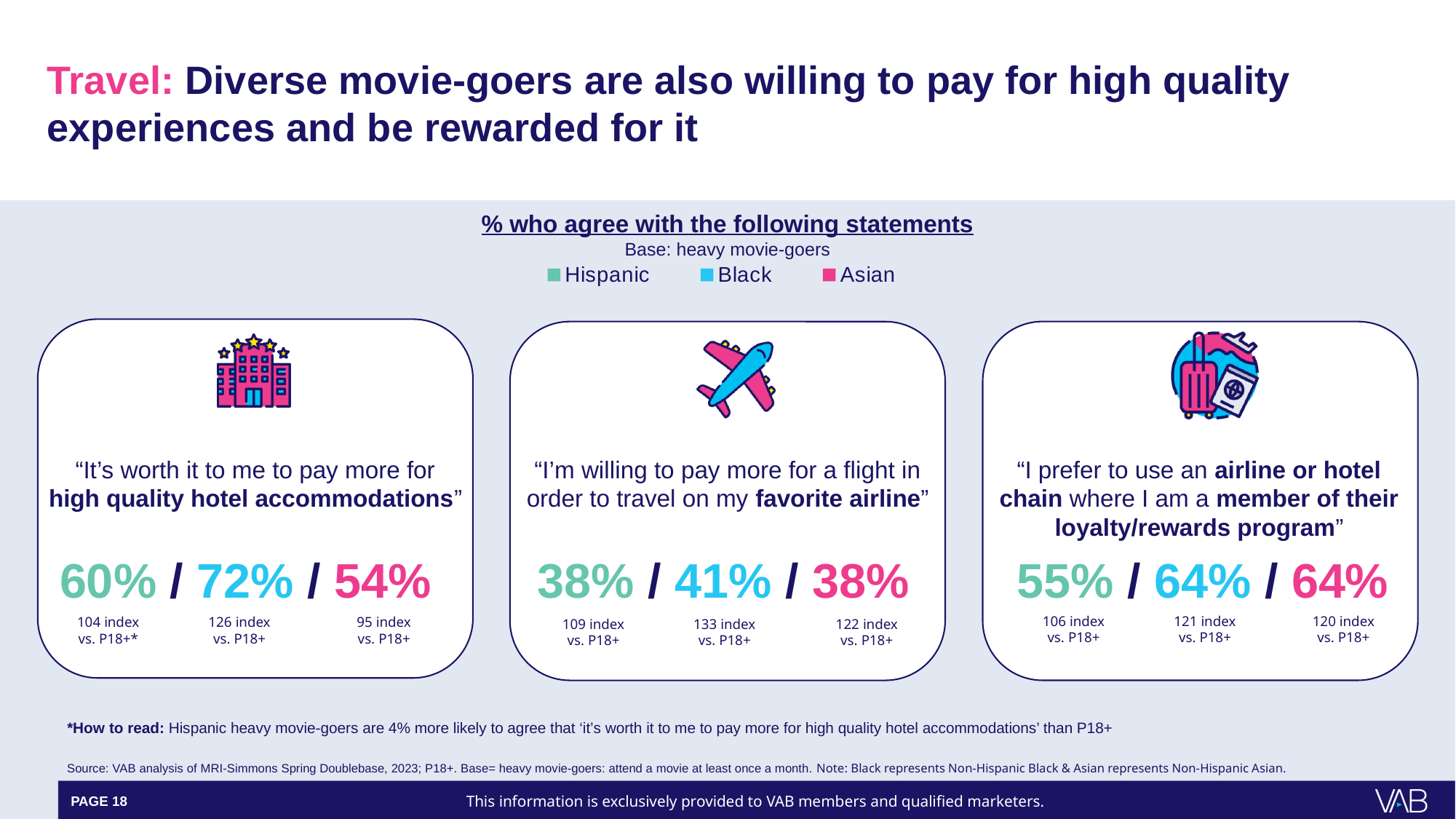
What percentage of Black heavy movie-goers agree they are willing to pay more for a flight to travel on their favorite airline? 41% What is the index vs. P18+ for Black heavy movie-goers on the favorite airline statement? 133 index For the high quality hotel accommodations statement, how many percentage points higher is the Black value than the Hispanic value? 12 percentage points Which group has the lowest percentage agreeing it's worth paying more for high quality hotel accommodations? Asian What is the base for the percentages shown? Heavy movie-goers How many statements are shown on the slide? 3 What percentage of Hispanic heavy movie-goers agree that it's worth it to pay more for high quality hotel accommodations? 60% Which group has the highest percentage agreeing it's worth paying more for high quality hotel accommodations? Black For the loyalty/rewards program statement, which is larger: the Hispanic value or the Black value? Black How many groups does the legend list? 3 What percentage of Asian heavy movie-goers prefer to use an airline or hotel chain where they are a member of the loyalty/rewards program? 64% Which group has the highest percentage agreeing they are willing to pay more for a flight on their favorite airline? Black